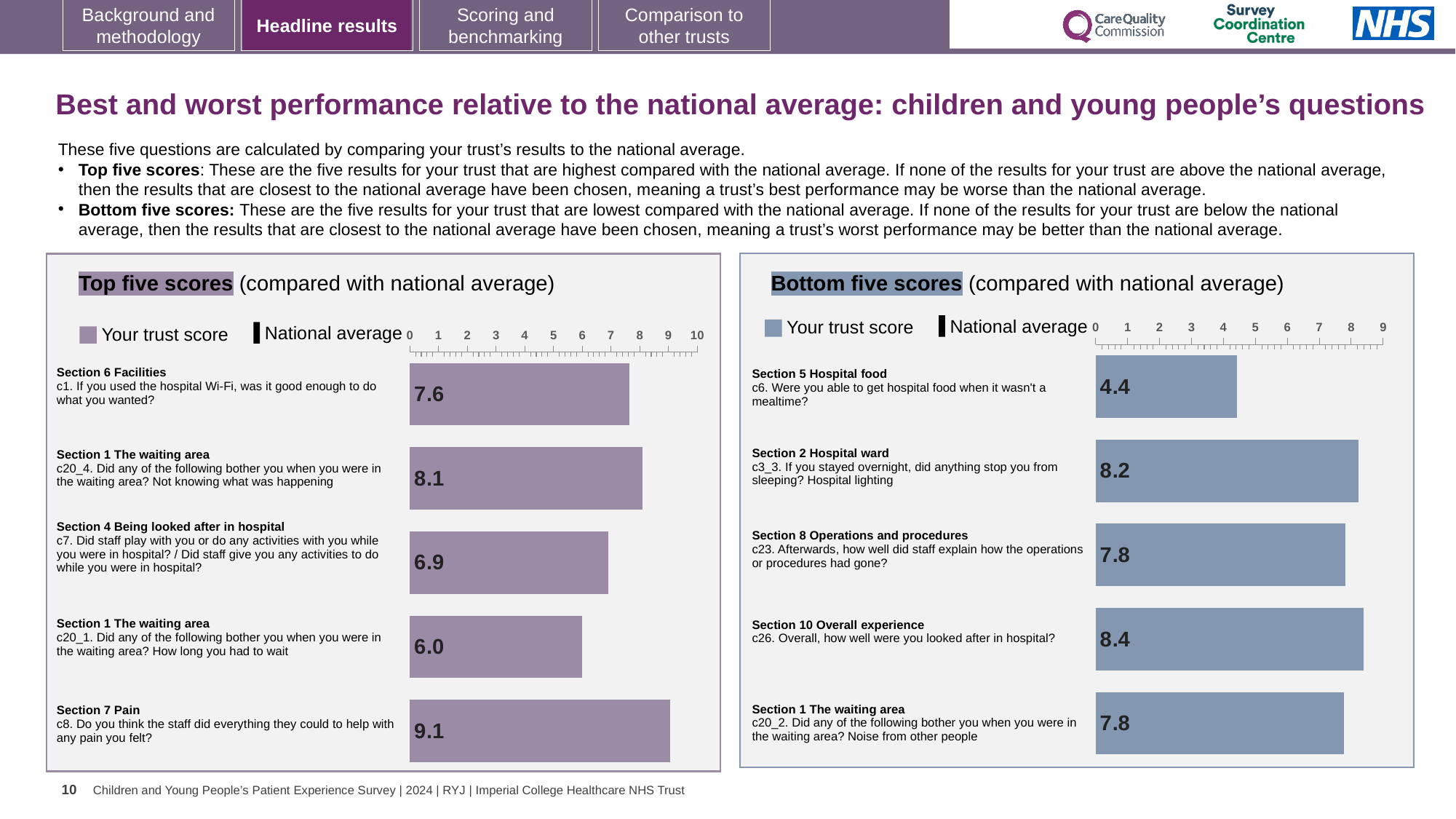
In the Bottom five scores chart, which question has the lowest trust score? c6 (Hospital food), 4.4 In the Top five scores chart, which question has the lowest trust score? c20_1 (how long you had to wait), 6.0 In the Top five scores chart, which question has the highest trust score? c8 (Section 7 Pain), 9.1 In the Bottom five scores chart, which has the larger score: c3_3 (hospital lighting) or c23 (staff explained how operations had gone)? c3_3 (hospital lighting), 8.2 In the Top five scores chart, what is the trust score for c8 (staff did everything they could to help with pain)? 9.1 In the Bottom five scores chart, which question has the highest trust score? c26 (Overall experience), 8.4 In the Top five scores chart, what is the difference between the scores for c8 (pain) and c20_1 (how long you had to wait)? 3.1 How many questions are plotted in the Bottom five scores chart? 5 In the Top five scores chart, what is the trust score for c1 (hospital Wi-Fi good enough to do what you wanted)? 7.6 In the Bottom five scores chart, what is the difference between the scores for c26 (overall experience) and c6 (hospital food)? 4.0 In the Bottom five scores chart, what is the trust score for c6 (able to get hospital food when it wasn't a mealtime)? 4.4 What type of chart is the Top five scores chart? Bar chart